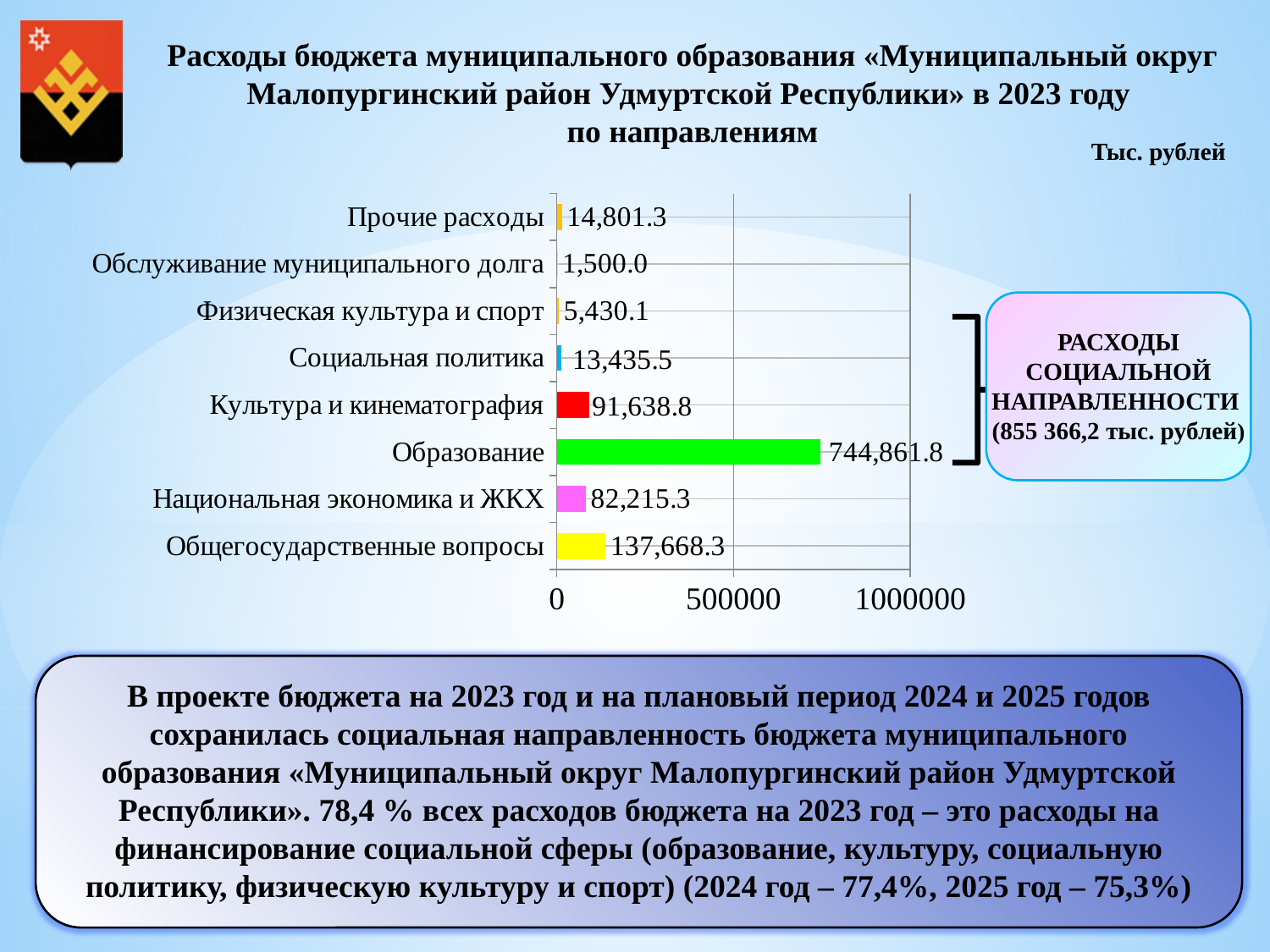
Which is larger: Культура и кинематография or Национальная экономика и ЖКХ? Культура и кинематография How many categories are shown in the chart? 8 What is the difference between Общегосударственные вопросы and Национальная экономика и ЖКХ? 55,453.0 In what units are the chart values given, according to the slide? Тыс. рублей Which category has the lowest value? Обслуживание муниципального долга Is the value for Образование greater or less than 500000? greater What is the value for Образование? 744,861.8 What kind of chart is shown on the slide? bar chart What is the value for Социальная политика? 13,435.5 Which category has the highest value? Образование What is the value for Обслуживание муниципального долга? 1,500.0 What is the value for Общегосударственные вопросы? 137,668.3